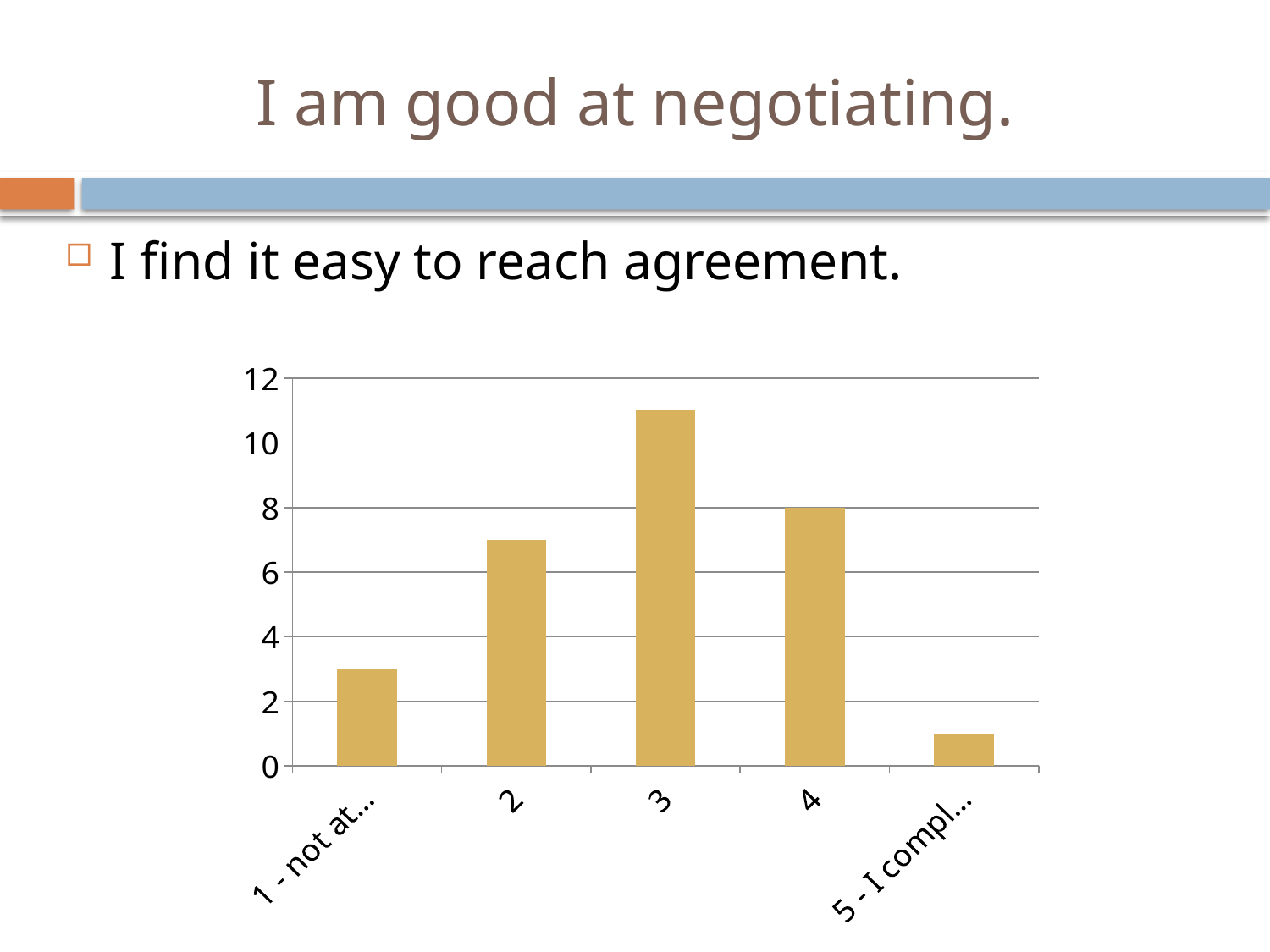
Which is larger, the value for category "1 - not at..." or the value for category "5 - I compl..."? 1 - not at... Which is larger, the value for category 2 or the value for category 4? 4 What is the value for category 4 in the chart? 8 Is the value for category 2 greater or less than 6? greater What is the highest value shown on the vertical axis of the chart? 12 Is the value for category 3 greater or less than 10? greater Is the value for category "5 - I compl..." greater or less than 2? less How many categories are plotted on the x axis of the chart? 5 What kind of chart is shown on the slide? bar chart Which category has the highest bar in the chart? 3 Which category has the lowest bar in the chart? 5 - I compl...